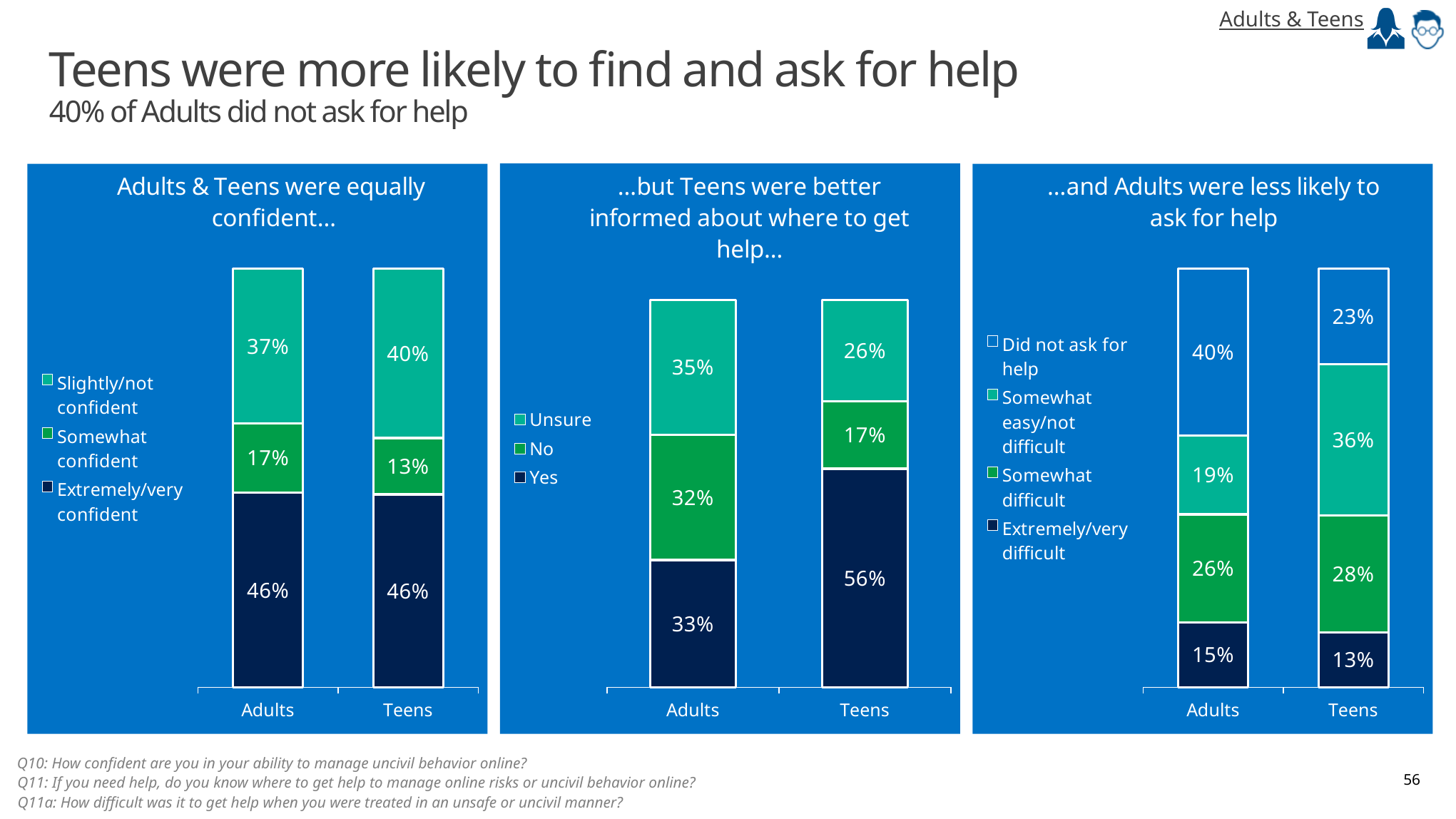
In the chart titled "...and Adults were less likely to ask for help", which group has the larger share for Did not ask for help, Adults or Teens? Adults In the chart titled "...but Teens were better informed about where to get help...", what is the difference between the Yes percentages for Teens and Adults? 23% In the chart titled "...but Teens were better informed about where to get help...", what percentage of Adults answered Unsure? 35% What kind of chart is the chart titled "Adults & Teens were equally confident..."? Stacked bar chart In the chart titled "...but Teens were better informed about where to get help...", which response is the smallest for Teens? No In the chart titled "...and Adults were less likely to ask for help", what percentage of Adults did not ask for help? 40% In the chart titled "...but Teens were better informed about where to get help...", what percentage of Teens answered Yes? 56% In the chart titled "...and Adults were less likely to ask for help", what is the total of the Adults bar? 100% In the chart titled "...and Adults were less likely to ask for help", what percentage of Teens found it Somewhat easy/not difficult? 36% In the chart titled "Adults & Teens were equally confident...", what percentage of Teens were Somewhat confident? 13% In the chart titled "Adults & Teens were equally confident...", which segment is the largest in the Adults bar? Extremely/very confident How many series does the legend list in the chart titled "...and Adults were less likely to ask for help"? 4